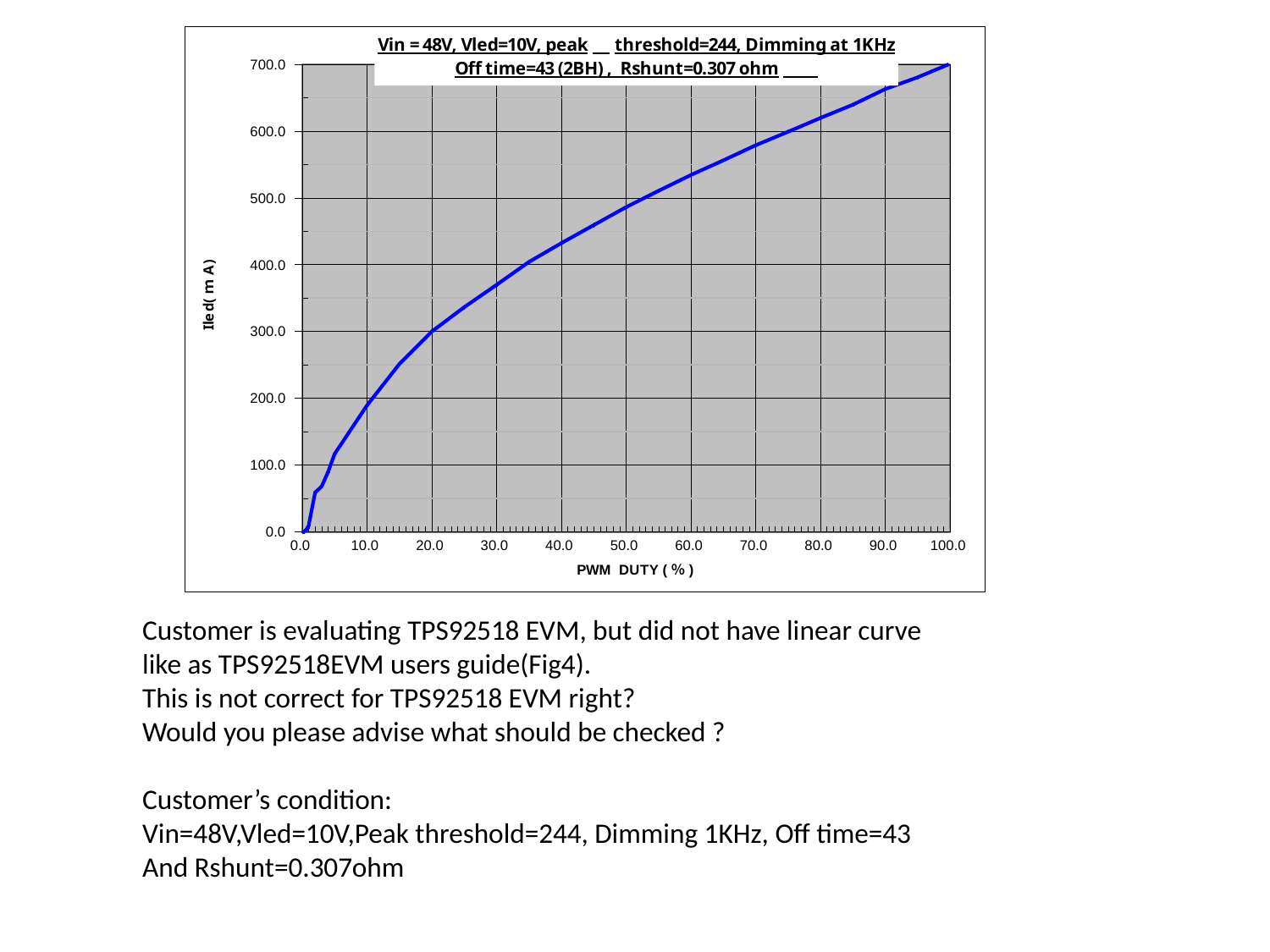
Is the value of Iled at 80.0% PWM duty greater or less than 600.0? greater What is the label of the x axis of the chart? PWM DUTY ( % ) Is the value of Iled at 10.0% PWM duty greater or less than 200.0? less Is the value of Iled at 50.0% PWM duty greater or less than 500.0? less What kind of chart is shown on the slide? line chart Does Iled rise or fall as PWM duty increases from 0.0 to 100.0? rise How many lines are plotted on the chart? 1 Which has the larger Iled value: 20.0% PWM duty or 40.0% PWM duty? 40.0% PWM duty What is the label of the y axis of the chart? Iled( m A )